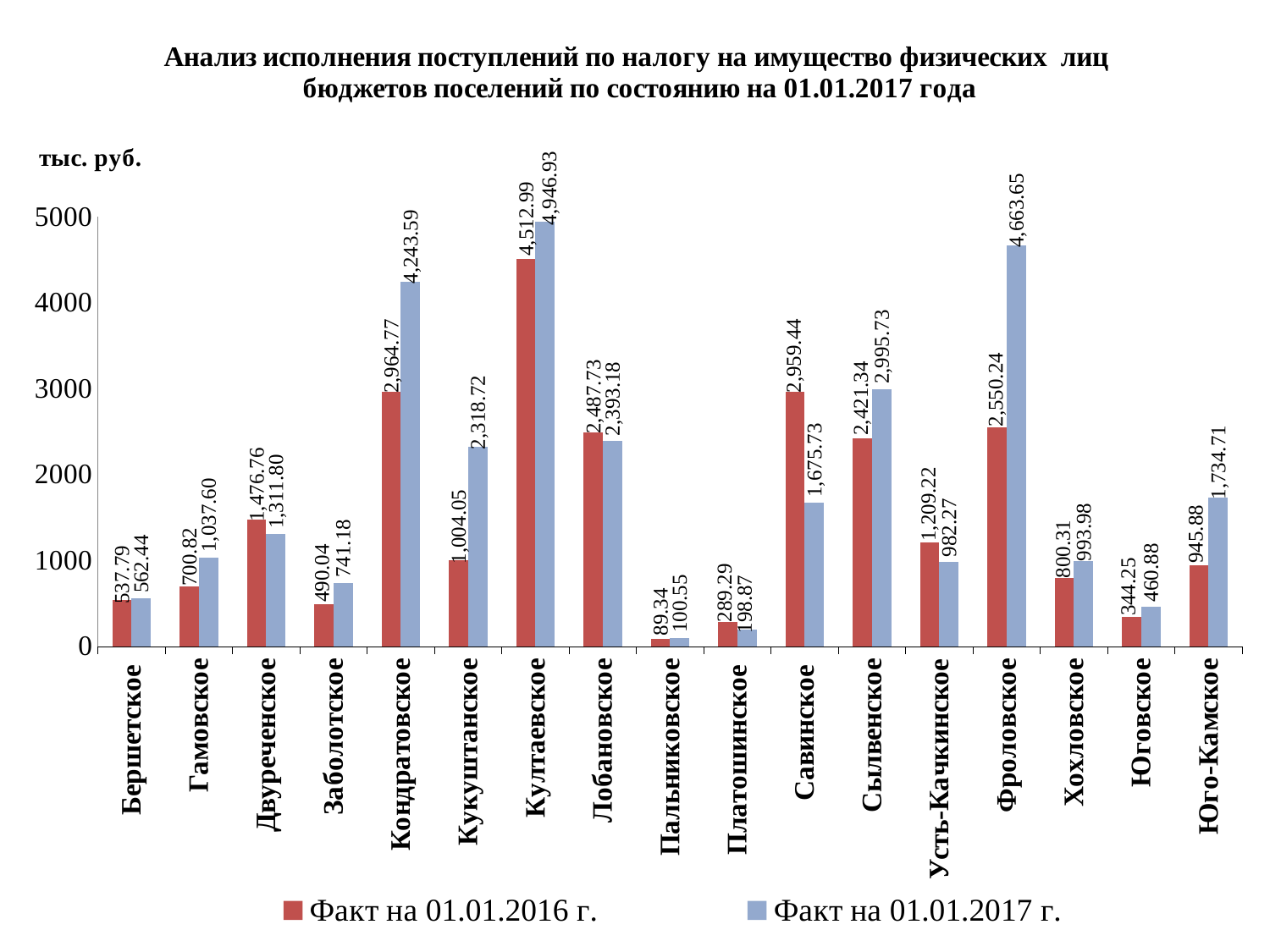
What is the value for Пальниковское in the series 'Факт на 01.01.2016 г.'? 89.34 How many series does the legend list? 2 Is the value for Кондратовское in the series 'Факт на 01.01.2017 г.' greater or less than 4000? greater What is the value for Савинское in the series 'Факт на 01.01.2016 г.'? 2,959.44 For Савинское, which is larger: the value for 'Факт на 01.01.2016 г.' or 'Факт на 01.01.2017 г.'? Факт на 01.01.2016 г. Which settlement has the highest value in the series 'Факт на 01.01.2017 г.'? Култаевское What is the difference between the 2017 and 2016 values for Фроловское? 2,113.41 Which settlement has the lowest value in the series 'Факт на 01.01.2016 г.'? Пальниковское What is the value for Култаевское in the series 'Факт на 01.01.2017 г.'? 4,946.93 How many settlements (categories) are shown on the x axis? 17 What type of chart is shown on the slide? bar chart What unit is indicated on the vertical axis of the chart? тыс. руб.